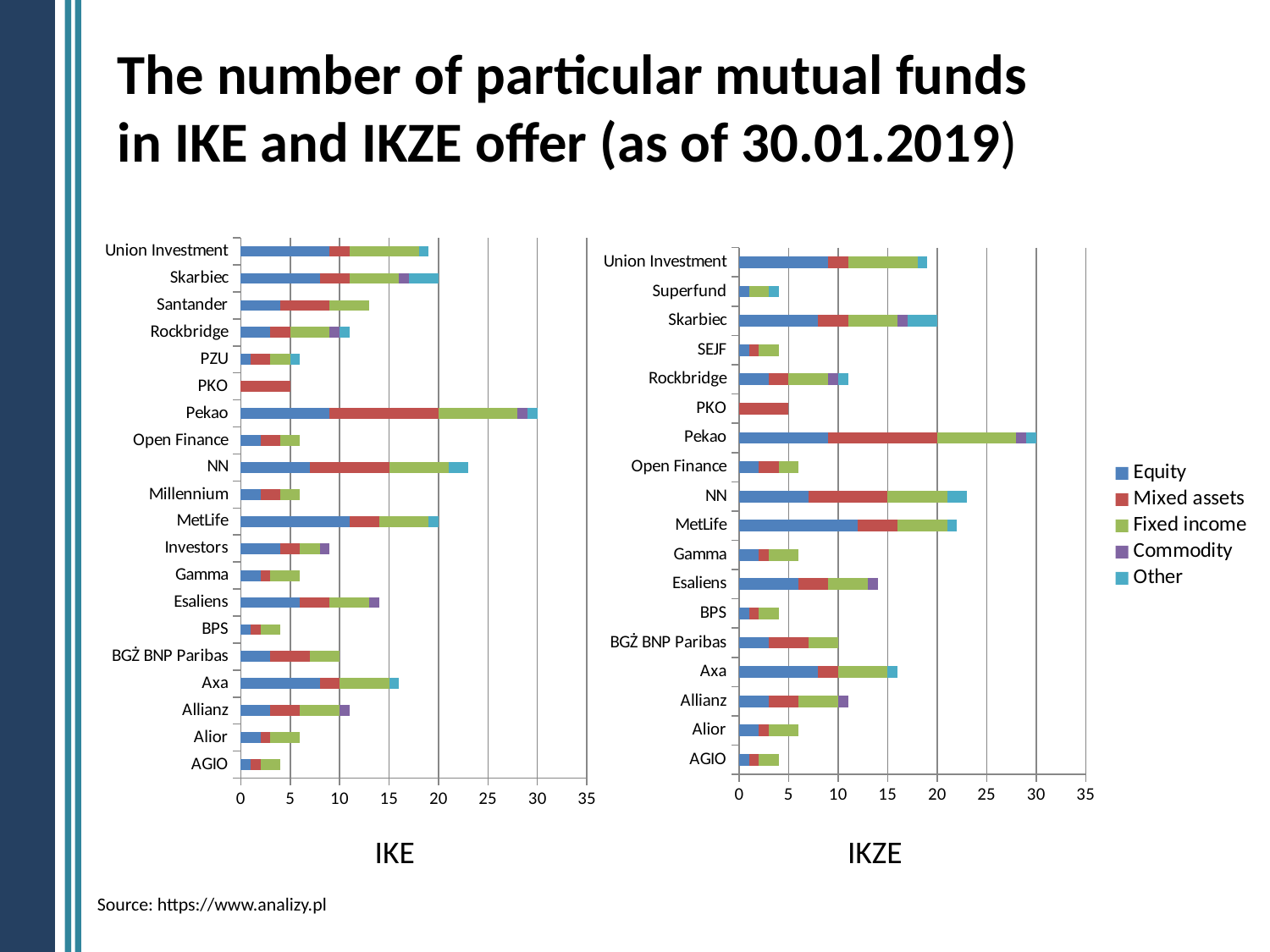
In the IKZE chart, which provider has the longest bar in total? Pekao In the IKZE chart, which has the longer total bar, MetLife or Axa? MetLife Which legend entry is shown in red? Mixed assets In the IKE chart, which provider has the longest bar in total? Pekao In the IKE chart, is the total bar for PKO greater or less than 10? less In the IKE chart, is the total bar for Pekao greater or less than 25? greater What kind of chart is the IKE chart on the left? Bar chart How many fund providers are shown in the IKZE chart? 18 In the IKZE chart, is the total bar for NN greater or less than 20? greater How many fund providers are shown in the IKE chart? 20 In the IKE chart, which has the longer total bar, Pekao or NN? Pekao How many series does the legend list? 5